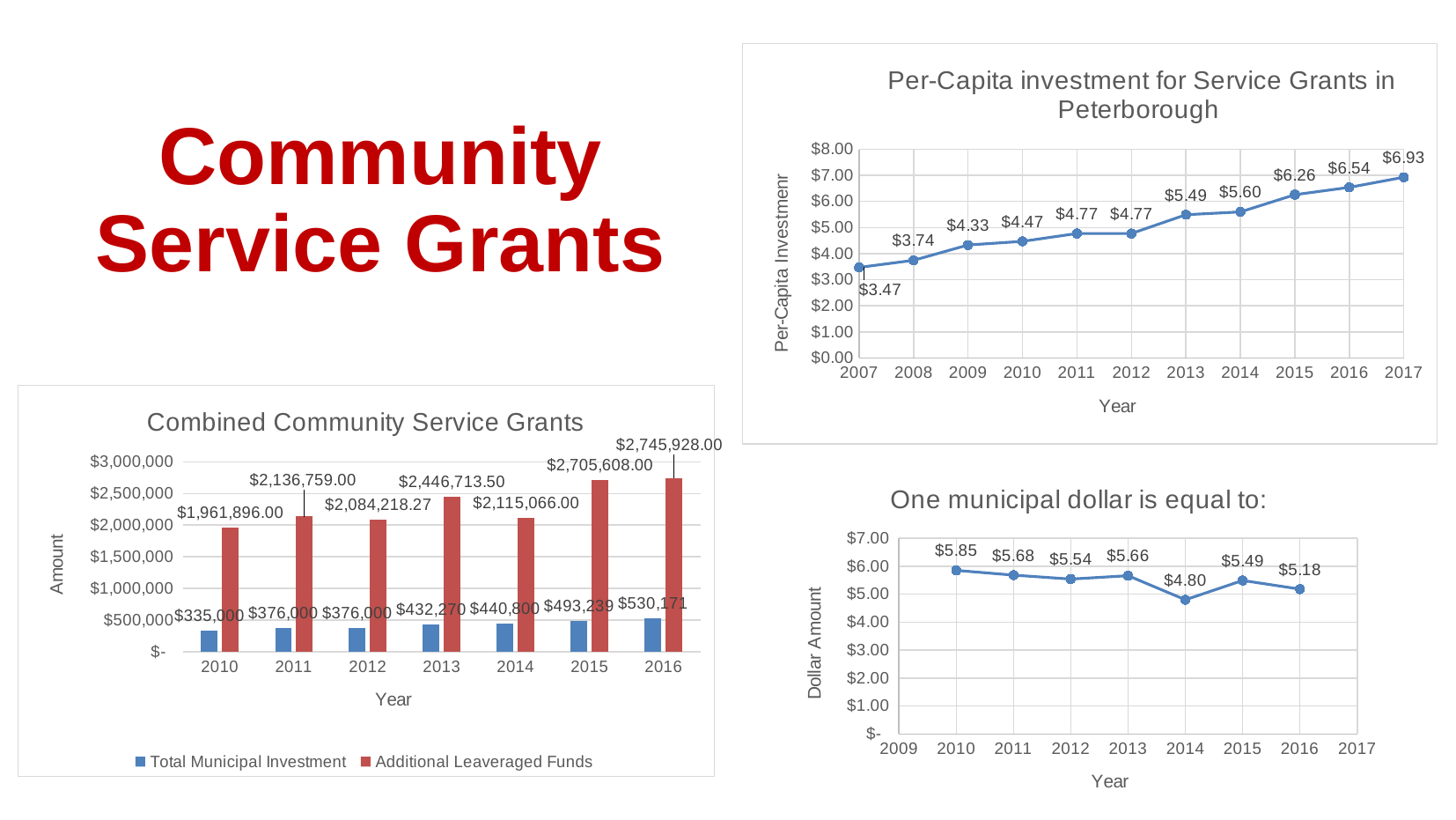
In the 'Combined Community Service Grants' chart, how many series does the legend list? 2 In the 'One municipal dollar is equal to:' chart, which year has the lowest value? 2014 In the 'Combined Community Service Grants' chart, what is the Additional Leaveraged Funds value for 2013? $2,446,713.50 In the 'Combined Community Service Grants' chart, which year has the lowest Additional Leaveraged Funds? 2010 In the 'Per-Capita investment for Service Grants in Peterborough' chart, which year has the highest value? 2017 In the 'Combined Community Service Grants' chart, what is the Total Municipal Investment for 2016? $530,171 In the 'Per-Capita investment for Service Grants in Peterborough' chart, what is the value for 2013? $5.49 In the 'One municipal dollar is equal to:' chart, which is larger, the value for 2010 or the value for 2016? 2010 In the 'Per-Capita investment for Service Grants in Peterborough' chart, do the values generally rise or fall from 2007 to 2017? rise In the 'Per-Capita investment for Service Grants in Peterborough' chart, how many years are plotted? 11 What kind of chart is 'Combined Community Service Grants'? bar chart In the 'Per-Capita investment for Service Grants in Peterborough' chart, what is the difference between the 2017 and 2007 values? $3.46